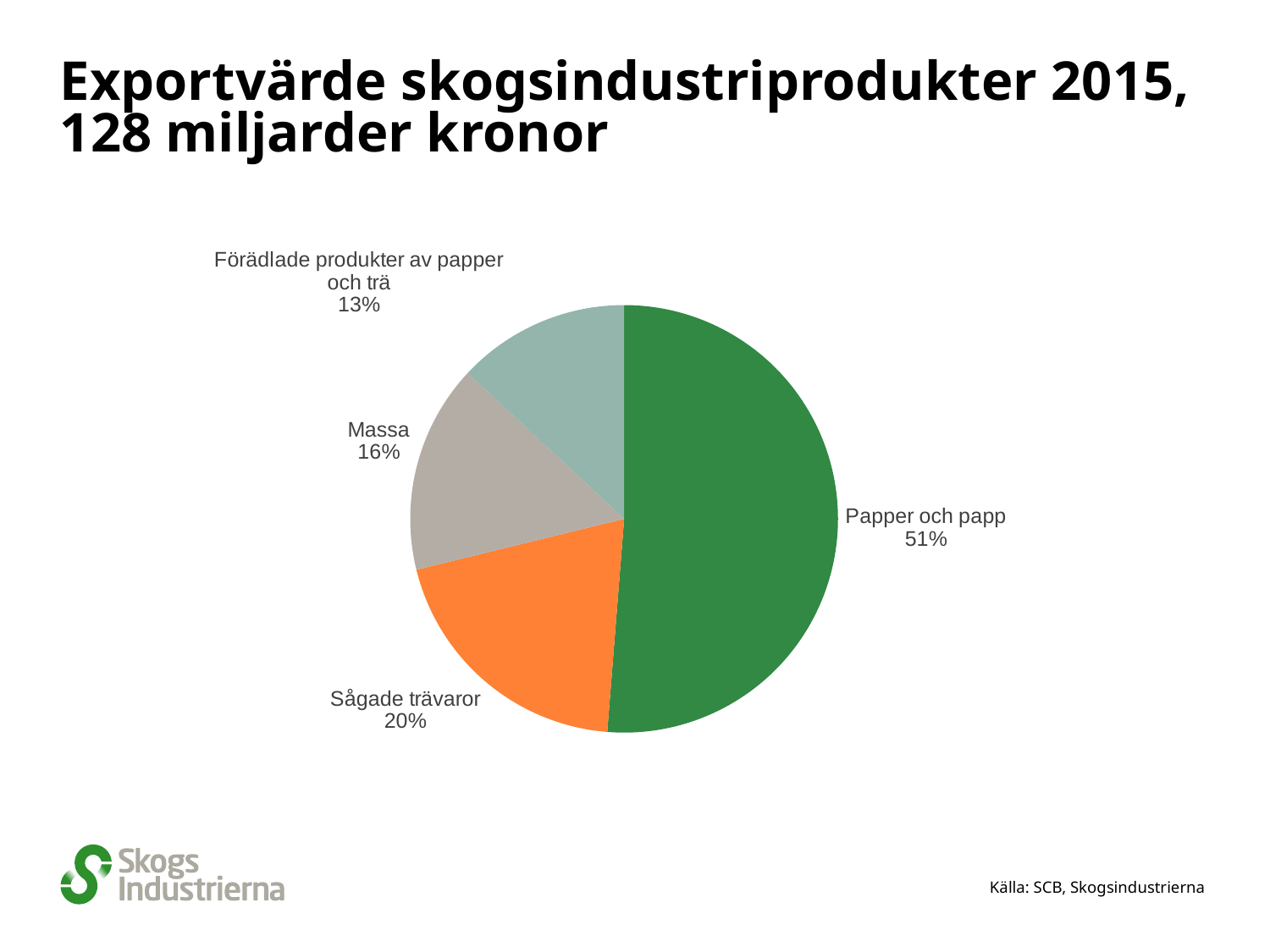
Which category has the largest slice of the pie? Papper och papp Which category has the smallest slice of the pie? Förädlade produkter av papper och trä What share of the pie does Massa represent? 16% Which is larger, the share for Sågade trävaror or the share for Massa? Sågade trävaror How many categories are shown in the pie chart? 4 What kind of chart is shown on the slide? Pie chart What is the difference in percentage points between Massa and Förädlade produkter av papper och trä? 3 What share of the pie does Sågade trävaror represent? 20% What is the difference in percentage points between Papper och papp and Sågade trävaror? 31 What share of the pie does Papper och papp represent? 51% What is the title of the slide? Exportvärde skogsindustriprodukter 2015, 128 miljarder kronor